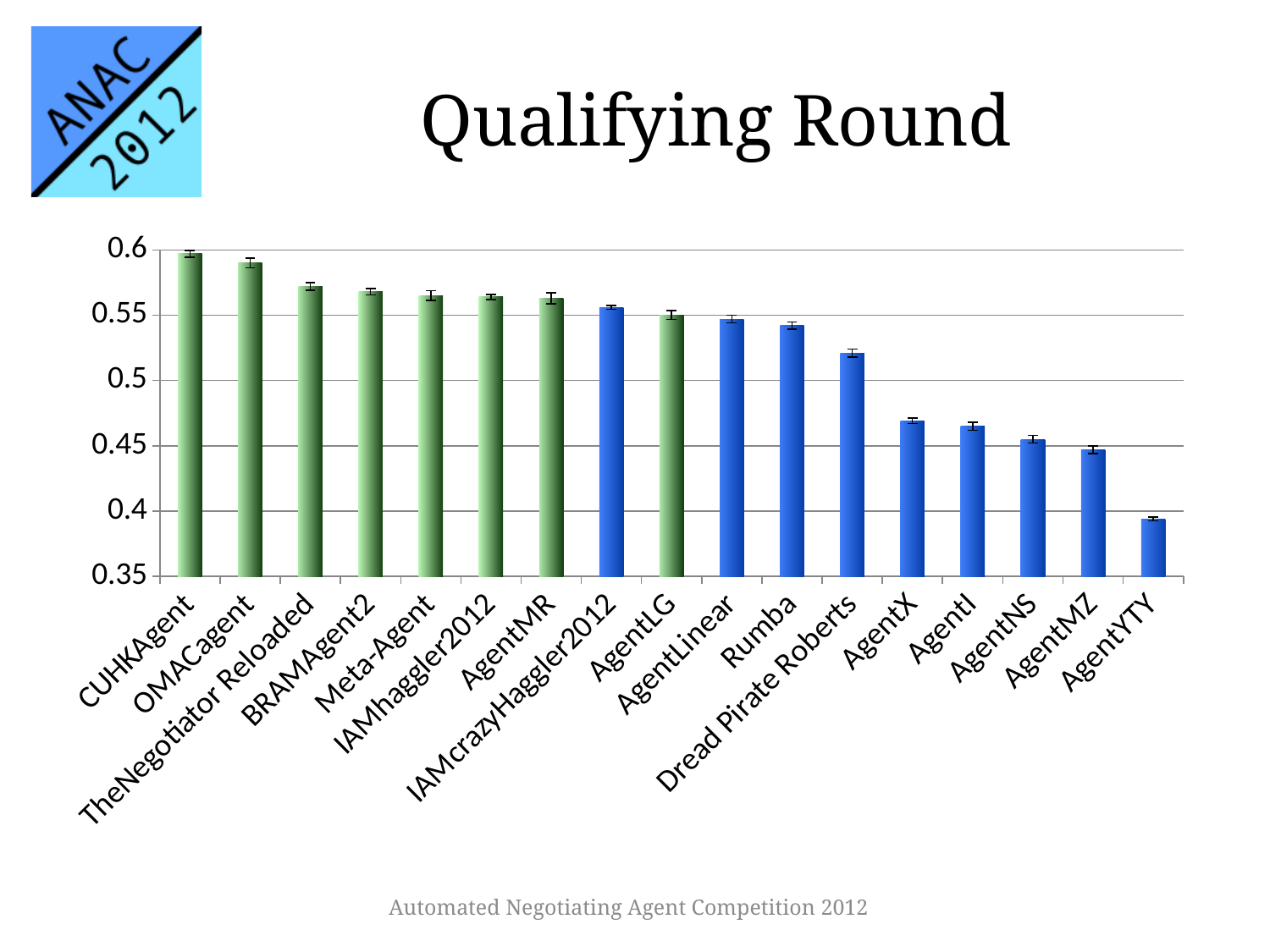
Is the value for CUHKAgent greater or less than 0.55? greater What kind of chart is shown on the slide? bar chart Which agent has the highest value in the chart? CUHKAgent How many agents (bars) are shown in the chart? 17 Which has the larger value, Dread Pirate Roberts or AgentX? Dread Pirate Roberts What is the title of the slide containing the chart? Qualifying Round Is the value for AgentYTY greater or less than 0.4? less Which agent has the lowest value in the chart? AgentYTY Is the value for Dread Pirate Roberts greater or less than 0.5? greater Do the values rise or fall moving from left to right along the x axis? fall Which has the larger value, AgentMZ or OMACagent? OMACagent